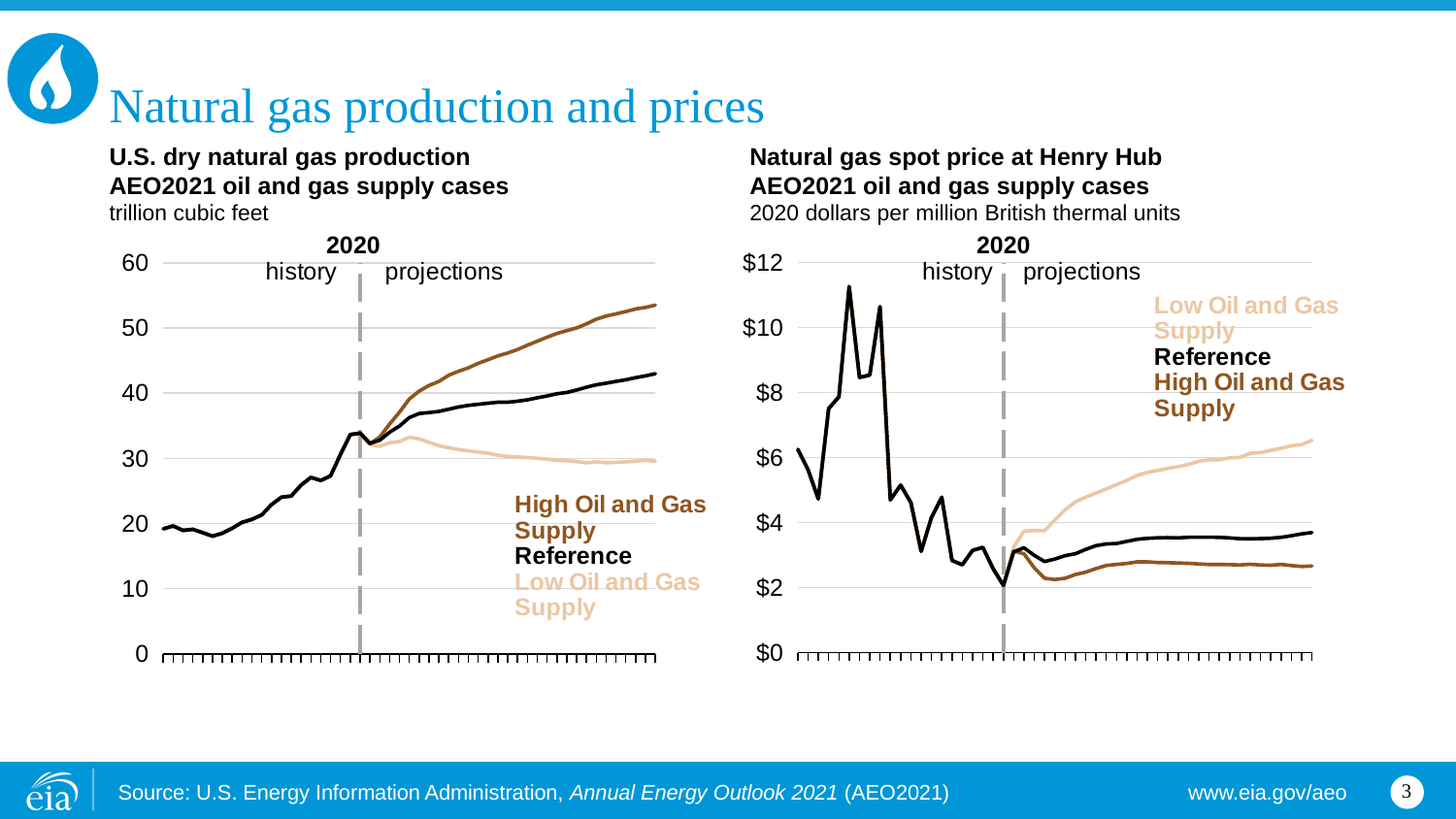
How many series are shown in the 'Natural gas spot price at Henry Hub' chart on the right? 3 In the 'U.S. dry natural gas production' chart, what unit is the y axis measured in? trillion cubic feet In the 'Natural gas spot price at Henry Hub' chart, is the final projected value for the High Oil and Gas Supply case greater or less than $4? less In the 'U.S. dry natural gas production' chart, which case has the higher value at the end of the projection period, High Oil and Gas Supply or Low Oil and Gas Supply? High Oil and Gas Supply In the 'Natural gas spot price at Henry Hub' chart, which case has the higher price at the end of the projection period, Low Oil and Gas Supply or High Oil and Gas Supply? Low Oil and Gas Supply In the 'U.S. dry natural gas production' chart, does the High Oil and Gas Supply line rise or fall over the projection period? rise In the 'U.S. dry natural gas production' chart, is the final projected value for the Low Oil and Gas Supply case greater or less than 40? less In the 'Natural gas spot price at Henry Hub' chart, is the final projected value for the Low Oil and Gas Supply case greater or less than $6? greater What type of chart is the 'U.S. dry natural gas production' chart on the left? line chart In the 'Natural gas spot price at Henry Hub' chart, what unit is the y axis measured in? 2020 dollars per million British thermal units In the 'U.S. dry natural gas production' chart, does the Low Oil and Gas Supply line rise or fall over the projection period? fall